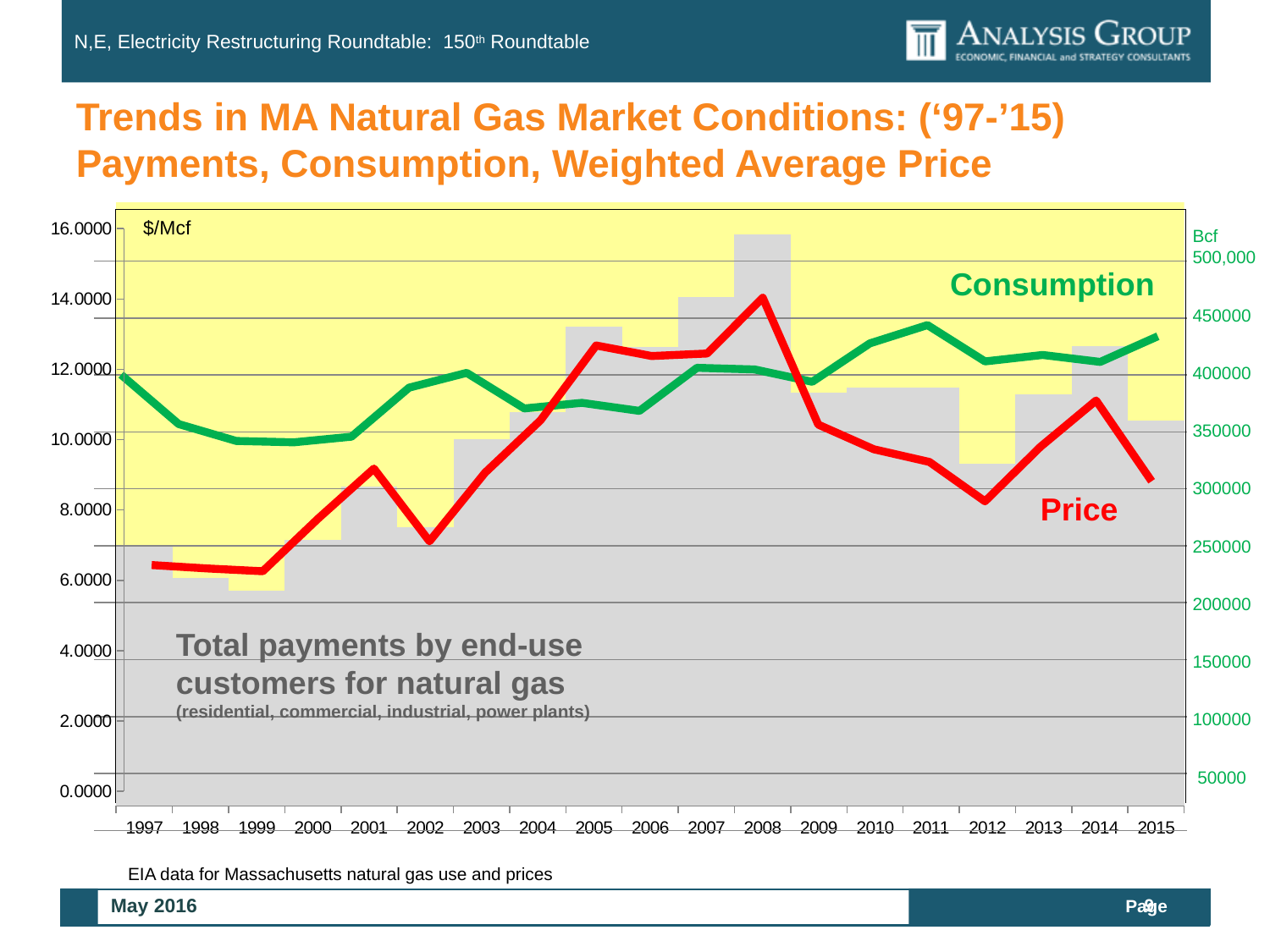
Is the Consumption value for 2011 greater or less than 400000 Bcf? greater In which year does the Consumption line reach its highest value? 2011 In which year are total payments by end-use customers (the gray bars) highest? 2008 In which year does the Price line reach its highest value? 2008 In which year does the Price line reach its lowest value? 1999 Which year has the higher Price, 2008 or 2015? 2008 How many years are shown along the x axis of the chart? 19 Is the Price value for 2008 greater or less than 12.0000 $/Mcf? greater What unit label is shown on the left vertical axis of the chart? $/Mcf What kind of chart is shown on the slide? A combination chart with bars and lines Is the Price value for 1997 greater or less than 8.0000 $/Mcf? less Does the Price line rise or fall between 2008 and 2012? fall